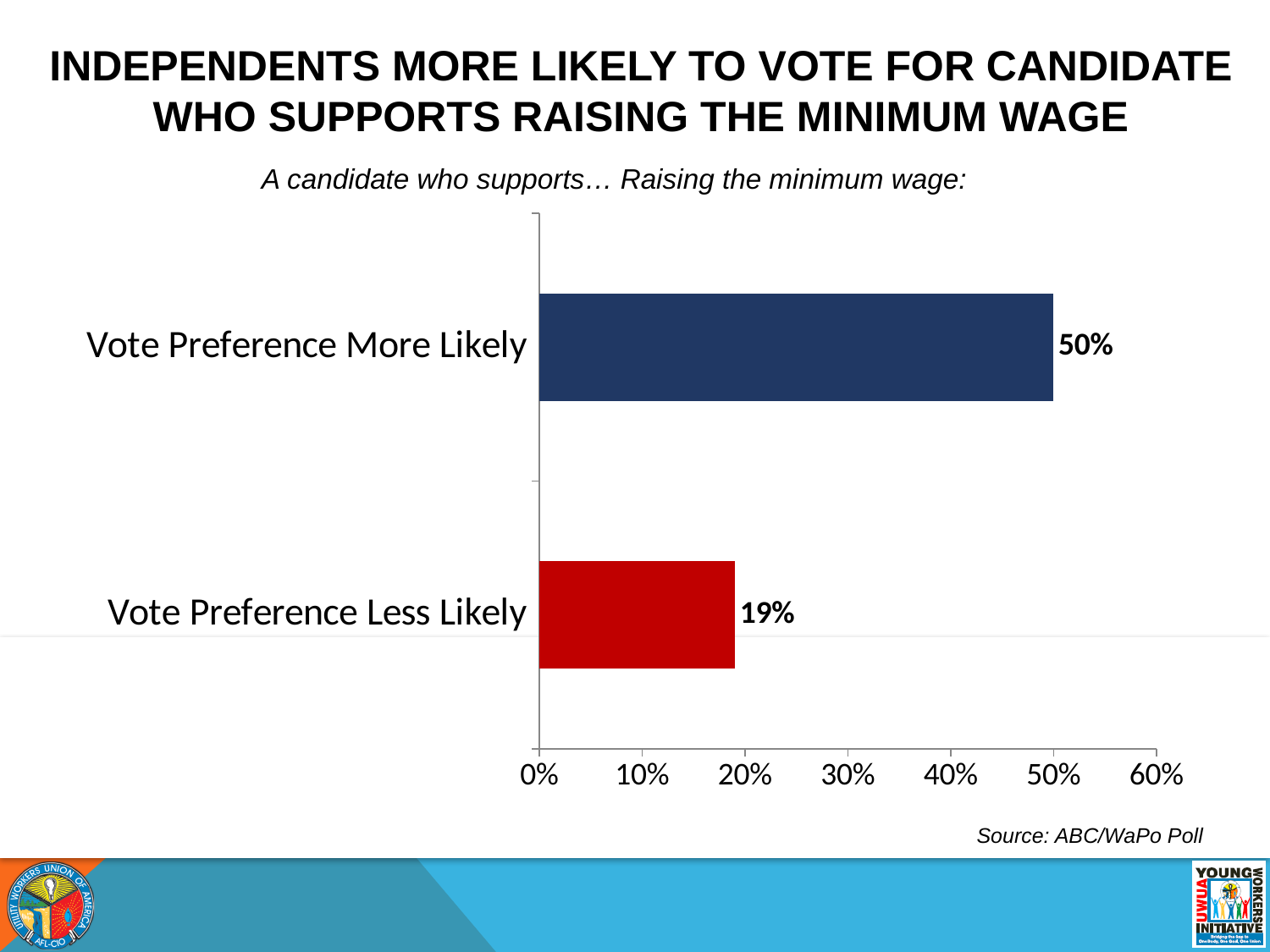
What is the maximum value shown on the x axis? 60% What colour is the bar for Vote Preference Less Likely? Red Is the value for Vote Preference Less Likely greater or less than 20%? less Which is larger, Vote Preference More Likely or Vote Preference Less Likely? Vote Preference More Likely Which category has the lowest value? Vote Preference Less Likely What kind of chart is shown on the slide? Bar chart What is the difference between Vote Preference More Likely and Vote Preference Less Likely? 31% What is the value for Vote Preference Less Likely? 19% Which category has the highest value? Vote Preference More Likely Is the value for Vote Preference More Likely greater or less than 40%? greater What is the value for Vote Preference More Likely? 50% How many categories are shown in the chart? 2